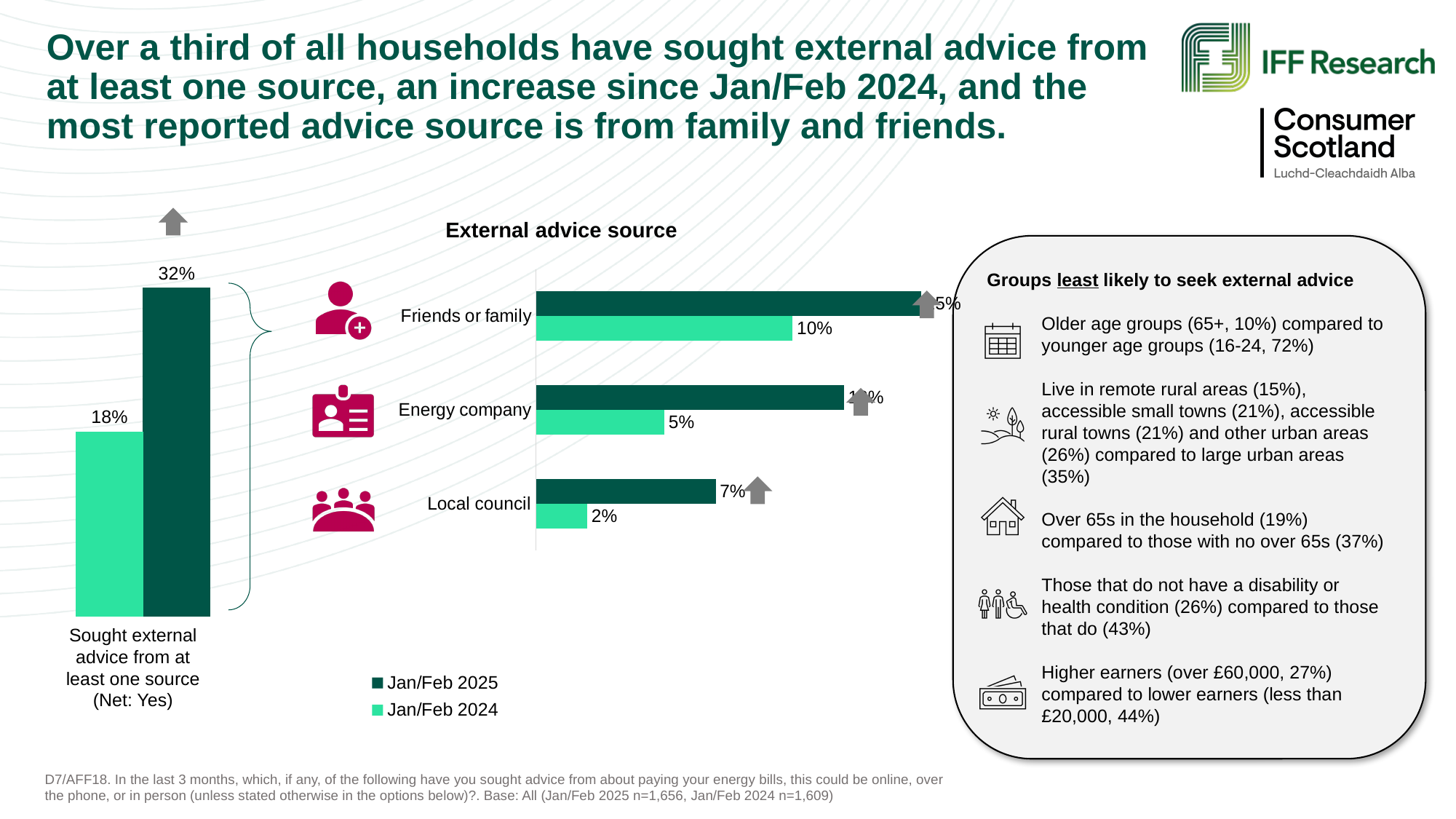
In the left chart, which period has the higher value, Jan/Feb 2024 or Jan/Feb 2025? Jan/Feb 2025 In the External advice source chart, what is the Jan/Feb 2024 value for Friends or family? 10% In the External advice source chart, what is the Jan/Feb 2024 value for Local council? 2% How many advice sources are shown in the External advice source chart? 3 In the External advice source chart, which advice source has the lowest Jan/Feb 2025 value? Local council In the External advice source chart, what is the difference between the Jan/Feb 2025 and Jan/Feb 2024 values for Local council? 5 percentage points In the External advice source chart, what is the Jan/Feb 2024 value for Energy company? 5% In the External advice source chart, what is the Jan/Feb 2025 value for Local council? 7% In the left chart, what percentage sought external advice from at least one source in Jan/Feb 2025? 32% In the External advice source chart, which advice source has the highest Jan/Feb 2024 value? Friends or family In the left chart, by how many percentage points did the share seeking external advice rise from Jan/Feb 2024 to Jan/Feb 2025? 14 percentage points In the left chart, what percentage sought external advice from at least one source in Jan/Feb 2024? 18%